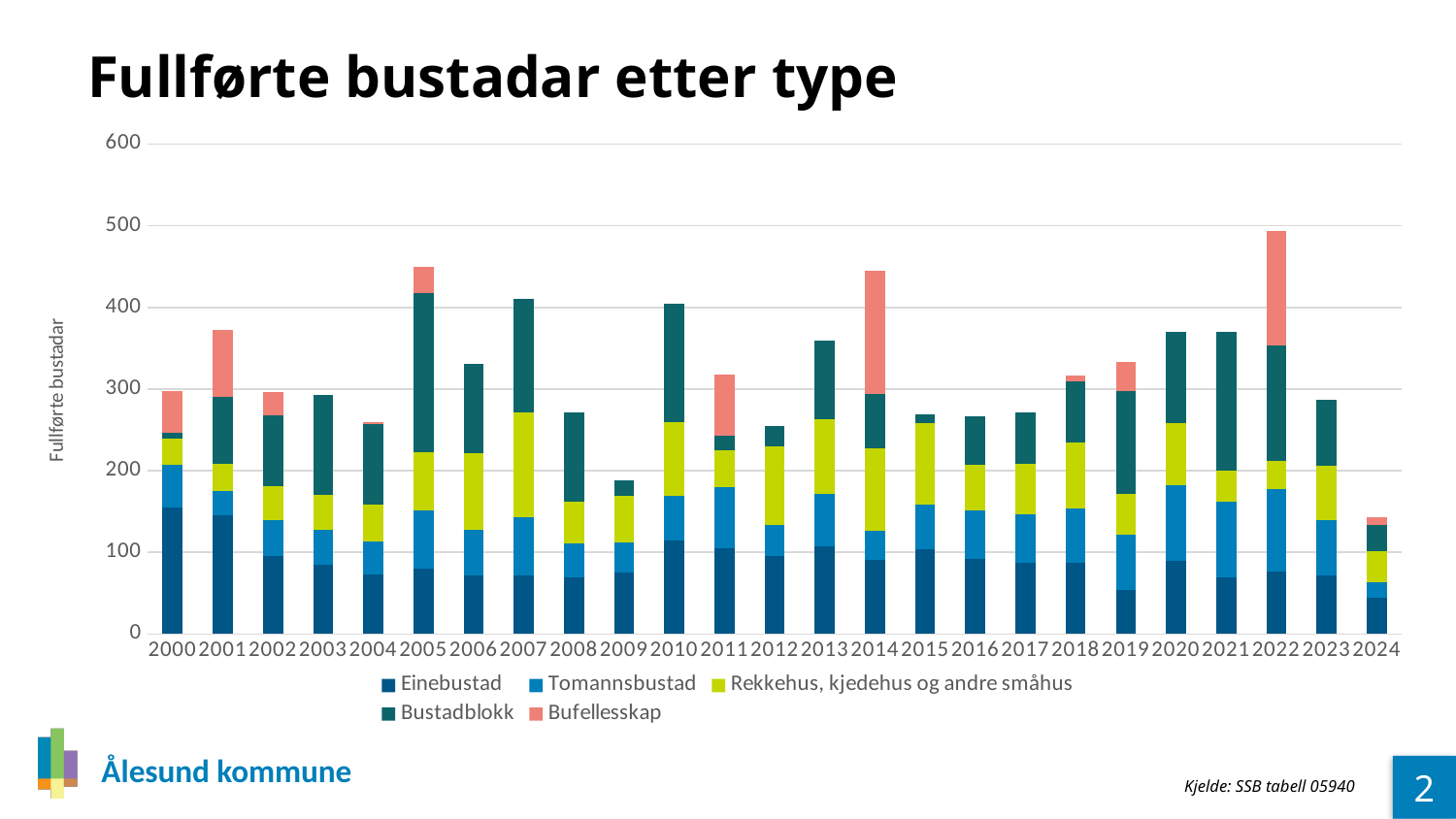
Which year has the highest total of completed dwellings? 2022 How many years are shown along the x axis? 25 Is the total for 2022 greater or less than 400? greater What is the title of the chart? Fullførte bustadar etter type Which series is shown in the salmon/red colour at the top of the bars? Bufellesskap Which year has a larger total, 2004 or 2005? 2005 How many series does the legend list? 5 Which year has the lowest total of completed dwellings? 2024 Is the total for 2024 greater or less than 200? less What kind of chart is shown on the slide? Stacked bar chart Is the total for 2014 greater or less than 400? greater Which year has a larger total, 2022 or 2023? 2022